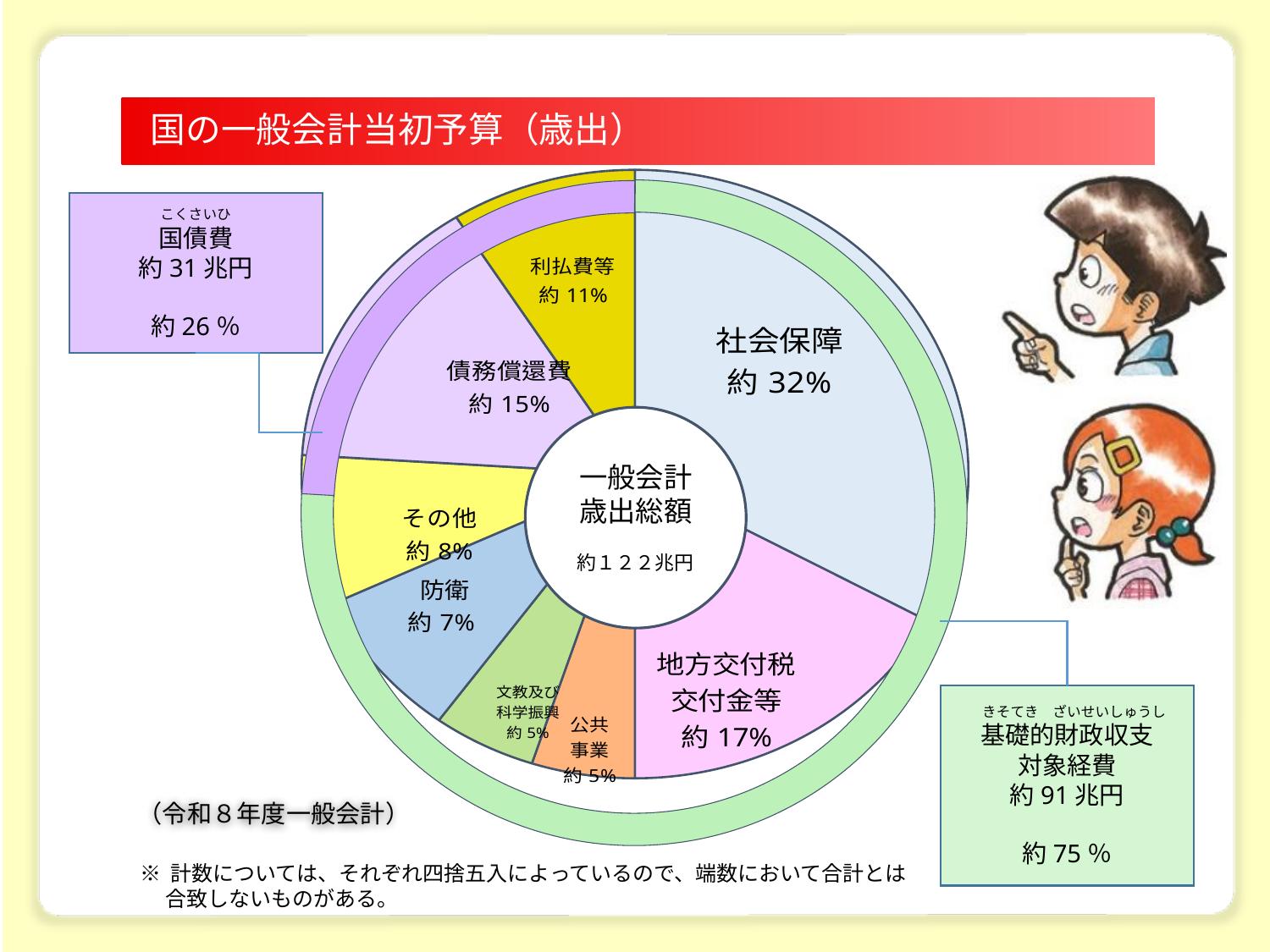
What share of the budget does 国債費 account for according to the label on the left? 約26% By how many percentage points does the share for 社会保障 exceed the share for 地方交付税交付金等? 15 What share of the budget does 社会保障 account for? 約32% What share of the budget does 債務償還費 account for? 約15% Which category has the largest share of the pie? 社会保障 What kind of chart is shown on the slide? pie chart What is the amount shown for 基礎的財政収支対象経費? 約91兆円 What share of the budget does 防衛 account for? 約7% How many slices does the pie chart have? 8 Which is larger, the share for 債務償還費 or the share for 利払費等? 債務償還費 What share of the budget does 地方交付税交付金等 account for? 約17% What is the total general account expenditure shown in the centre of the chart? 約１２２兆円